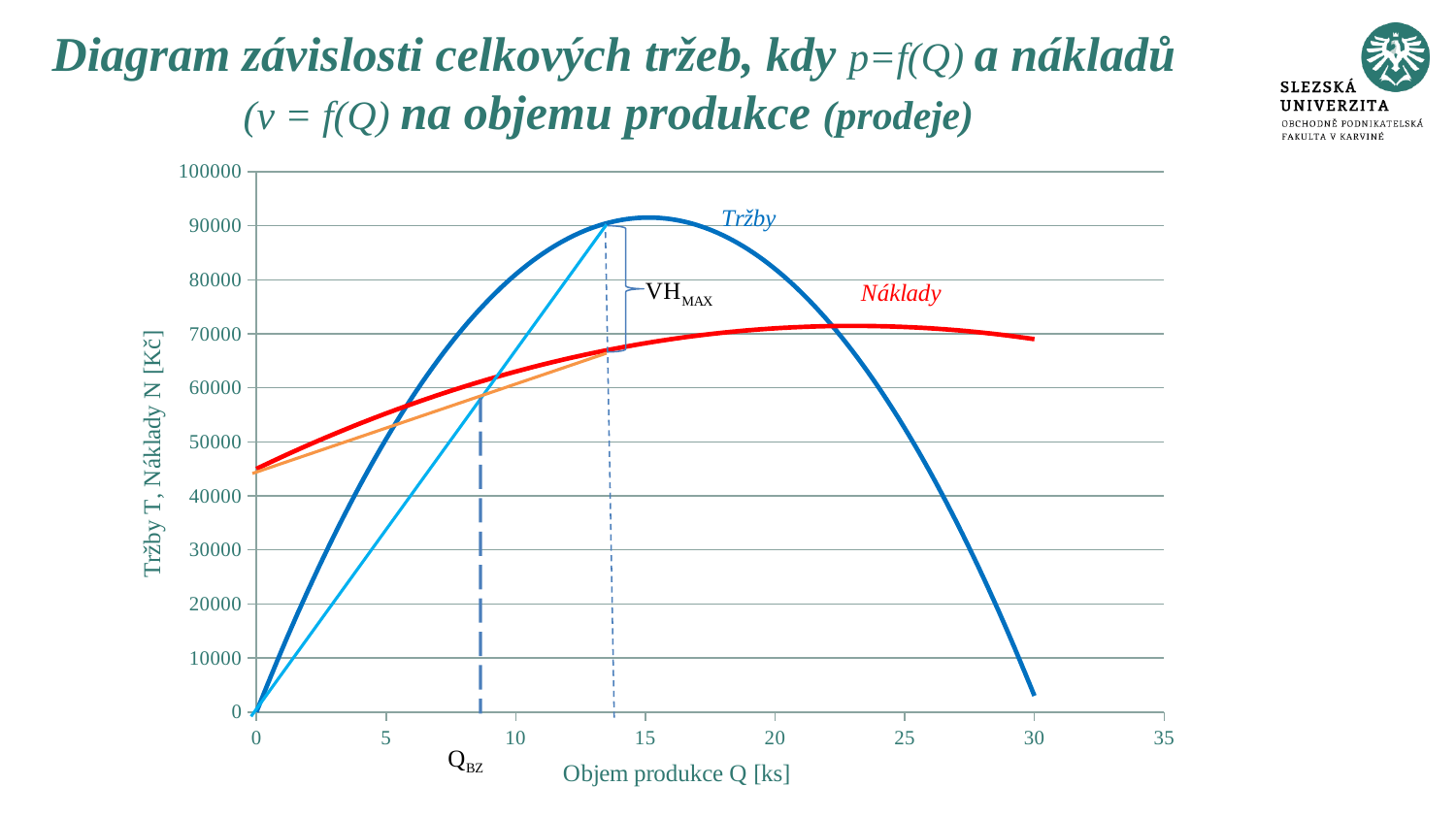
What is the title of the x axis of the chart? Objem produkce Q [ks] Is the value of Náklady at Q = 30 greater or less than 80000? less Is the value of Tržby at Q = 30 greater or less than 10000? less What kind of chart is shown on the slide? line chart What is the value of Tržby at Q = 0? 0 At Q = 15, which curve is higher, Tržby or Náklady? Tržby How many labelled curves (series) are plotted on the chart? 2 Is the value of Tržby at Q = 20 greater or less than 70000? greater What is the title of the y axis of the chart? Tržby T, Náklady N [Kč] At Q = 30, which curve is higher, Tržby or Náklady? Náklady Does the Tržby curve rise or fall between Q = 15 and Q = 30? fall